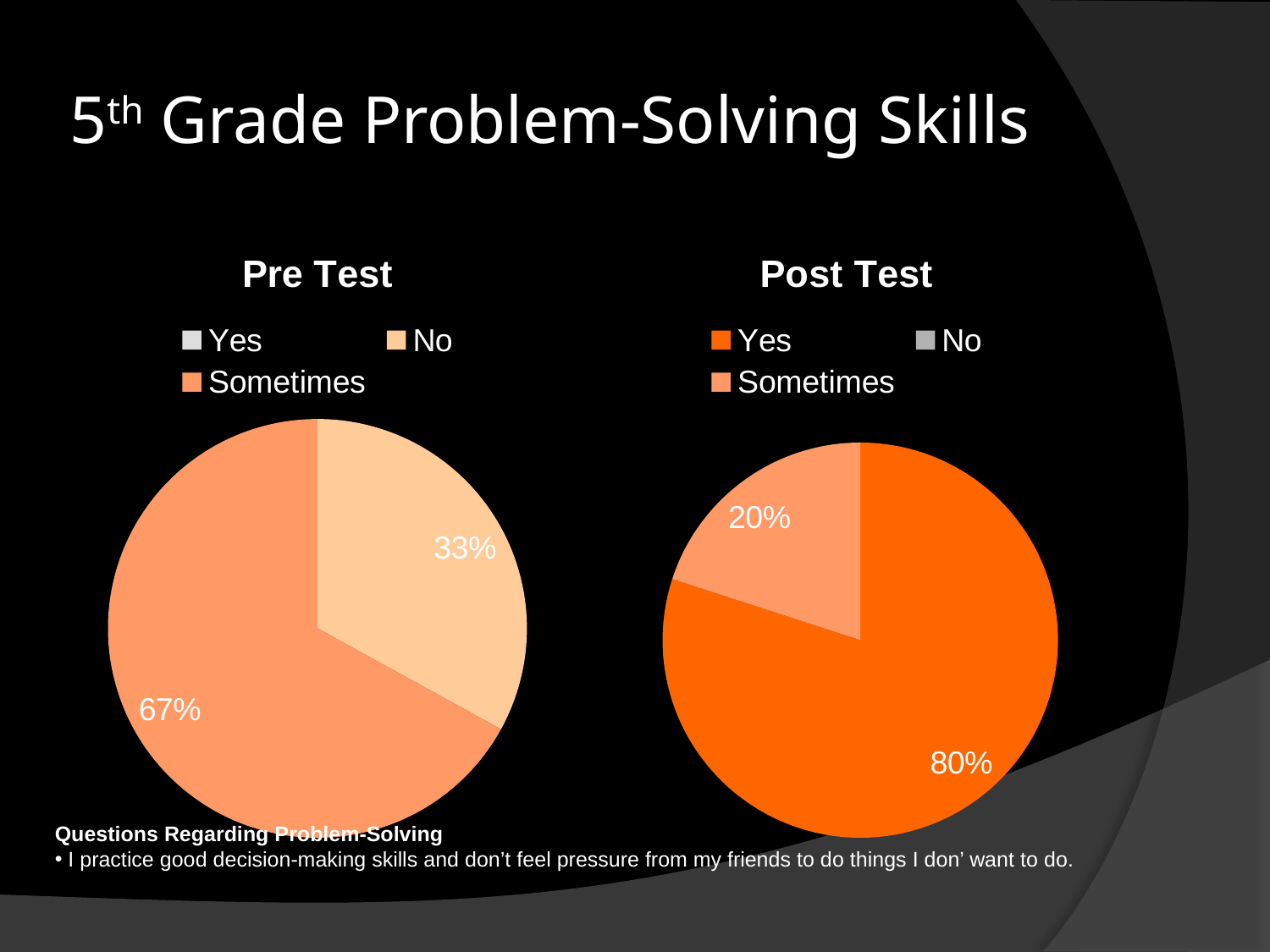
In the Pre Test chart, what percentage is shown for No? 33% What is the title of the chart on the left side of the slide? Pre Test What type of chart is used for the Pre Test and Post Test data? Pie chart In the Post Test chart, what percentage is shown for Yes? 80% In the Pre Test chart, what percentage is shown for Sometimes? 67% In the Post Test chart, what percentage is shown for Sometimes? 20% In the Post Test chart, which category has the largest slice? Yes How many entries does the legend of the Post Test chart list? 3 Which is larger: Sometimes in the Pre Test chart or Sometimes in the Post Test chart? Pre Test In the Pre Test chart, what is the difference between the Sometimes and No percentages? 34% In the Pre Test chart, which category has the largest slice? Sometimes In the Post Test chart, what is the difference between the Yes and Sometimes percentages? 60%